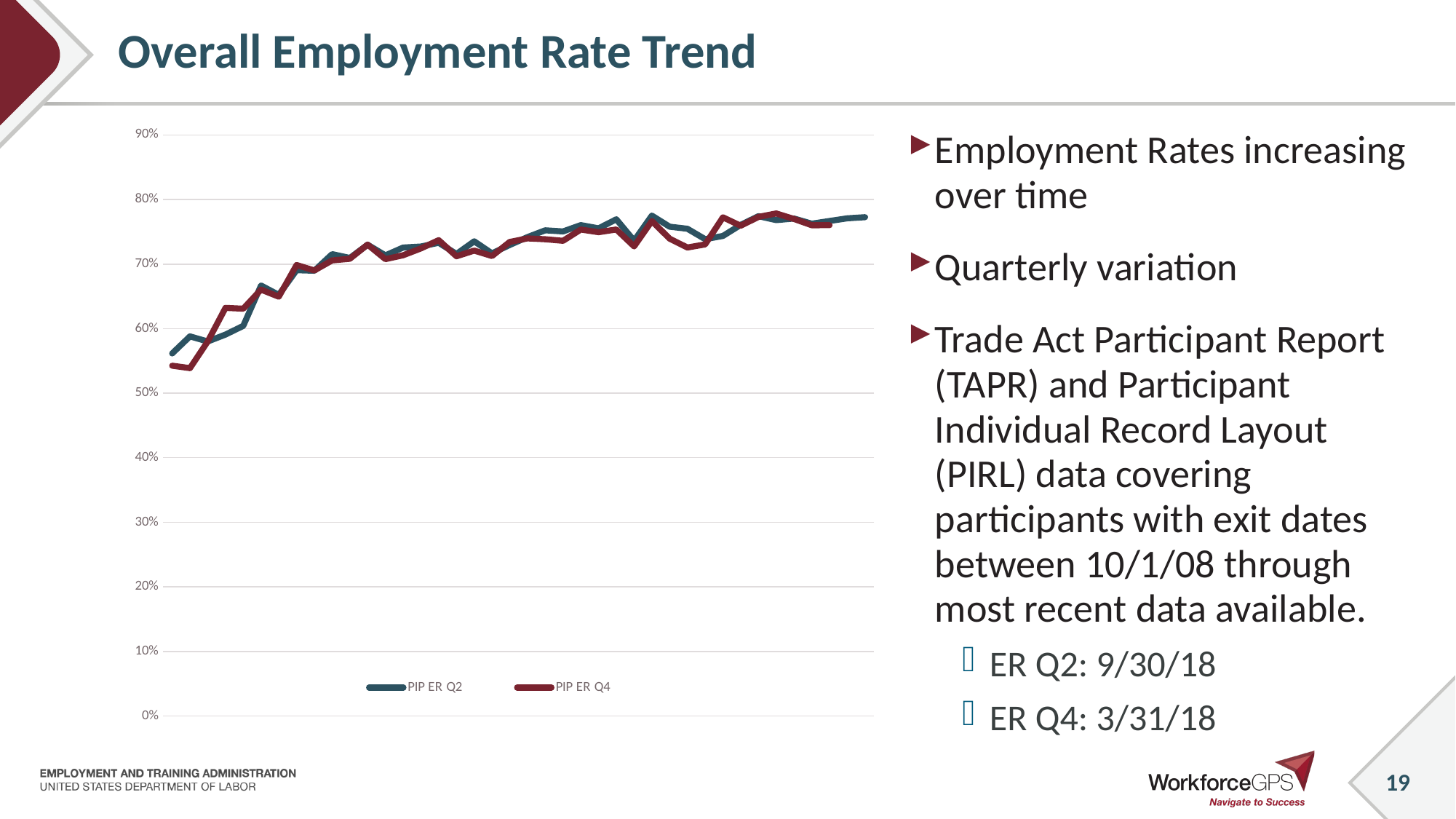
What are the two series named in the chart's legend? PIP ER Q2 and PIP ER Q4 What kind of chart is shown on the slide? line chart Do the values of the PIP ER Q4 series generally rise or fall from left to right along the x axis? rise Is the first (leftmost) value of the PIP ER Q4 series greater or less than 60%? less Is the first (leftmost) value of the PIP ER Q2 series greater or less than 50%? greater Which series is drawn in dark red, PIP ER Q2 or PIP ER Q4? PIP ER Q4 How many series does the chart's legend list? 2 Do the values of the PIP ER Q2 series generally rise or fall from left to right along the x axis? rise Is the highest value reached by the PIP ER Q4 series greater or less than 80%? less What is the highest value labelled on the chart's y axis? 90%